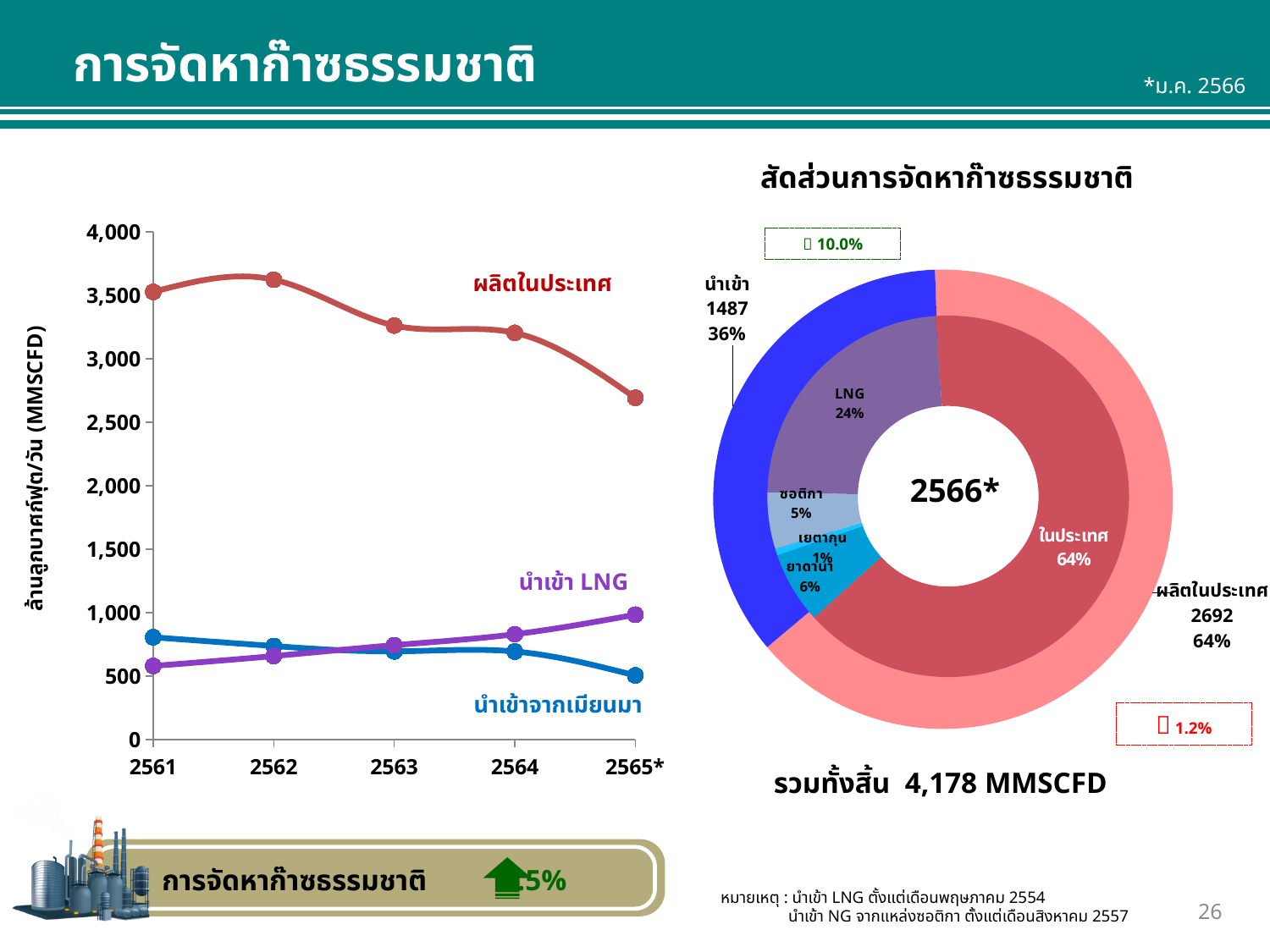
In the doughnut chart สัดส่วนการจัดหาก๊าซธรรมชาติ, what value is shown for ผลิตในประเทศ? 2692 In the line chart on the left, does the นำเข้า LNG series rise or fall from 2561 to 2565*? rise In the line chart on the left, is the value for นำเข้า LNG in 2565* greater or less than 500? greater In the doughnut chart สัดส่วนการจัดหาก๊าซธรรมชาติ, what share does นำเข้า have? 36% In the doughnut chart สัดส่วนการจัดหาก๊าซธรรมชาติ, what is the difference between ผลิตในประเทศ (2692) and นำเข้า (1487)? 1205 In the line chart on the left, is the value for ผลิตในประเทศ in 2565* greater or less than 3,000? less In the line chart on the left, which is larger in 2565*: นำเข้า LNG or นำเข้าจากเมียนมา? นำเข้า LNG What total is shown below the doughnut chart สัดส่วนการจัดหาก๊าซธรรมชาติ? 4,178 MMSCFD In the line chart on the left, how many years are shown on the x axis? 5 What kind of chart is the chart on the left of the slide? line chart In the doughnut chart สัดส่วนการจัดหาก๊าซธรรมชาติ, what share does LNG have? 24% In the line chart on the left, how many data series are plotted? 3